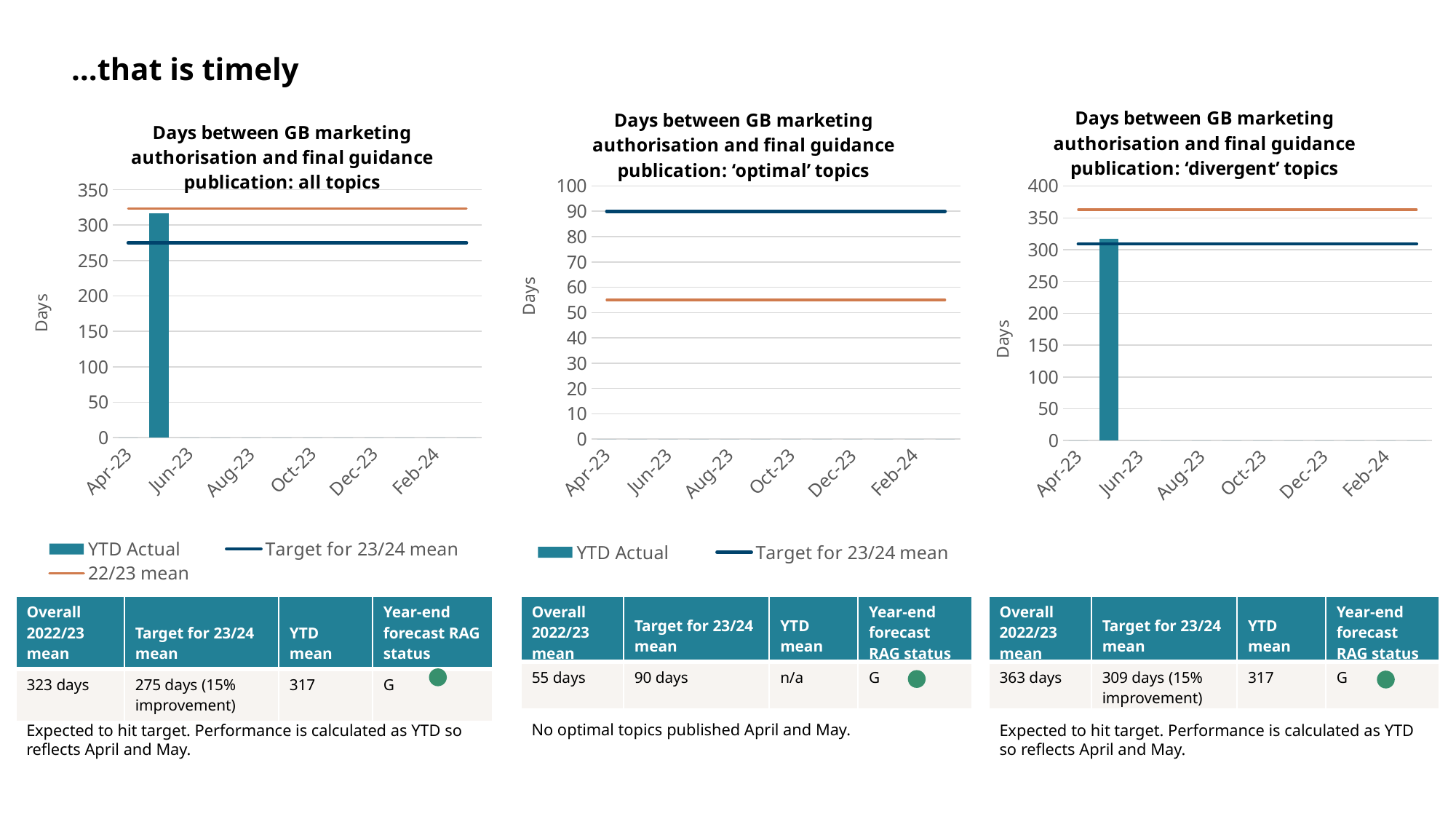
How many series does the legend of the middle chart ('optimal' topics) list? 2 In the left chart (all topics), is the YTD Actual bar greater or less than 300? greater How many series does the legend of the left chart (all topics) list? 3 How many month labels are shown on the x axis of the right chart ('divergent' topics)? 6 What kind of chart is the left chart, 'Days between GB marketing authorisation and final guidance publication: all topics'? combination bar and line chart According to the table under the right chart ('divergent' topics), what is the Overall 2022/23 mean? 363 days In the left chart (all topics), which line is higher: the 22/23 mean or the Target for 23/24 mean? 22/23 mean According to the table under the left chart (all topics), what is the YTD mean? 317 In the right chart ('divergent' topics), is the YTD Actual bar greater or less than 300? greater In the middle chart ('optimal' topics), is the 22/23 mean line greater or less than 50? greater In the middle chart ('optimal' topics), which line is higher: the Target for 23/24 mean or the 22/23 mean? Target for 23/24 mean